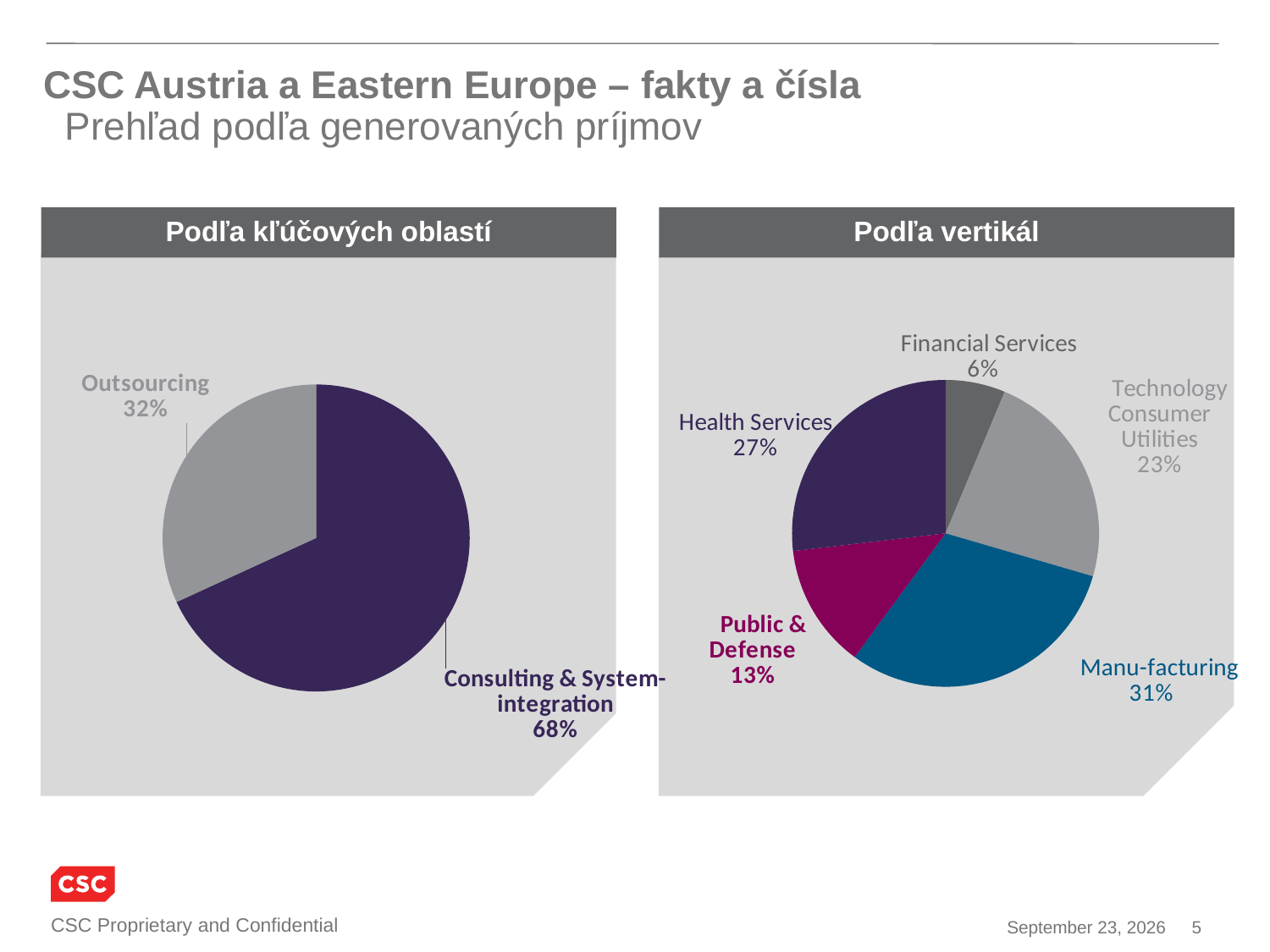
What kind of chart is shown in the 'Podľa kľúčových oblastí' panel? Pie chart In the 'Podľa kľúčových oblastí' chart, what is the difference between Consulting & System-integration and Outsourcing? 36% In the 'Podľa vertikál' chart, what share does Health Services have? 27% In the 'Podľa kľúčových oblastí' chart, what share does Outsourcing have? 32% In the 'Podľa vertikál' chart, which slice is the largest? Manu-facturing In the 'Podľa vertikál' chart, how many slices does the pie have? 5 In the 'Podľa vertikál' chart, which slice is the smallest? Financial Services In the 'Podľa kľúčových oblastí' chart, which slice is the largest? Consulting & System-integration In the 'Podľa vertikál' chart, what share does Manu-facturing have? 31% In the 'Podľa kľúčových oblastí' chart, what share does Consulting & System-integration have? 68% In the 'Podľa vertikál' chart, which is larger: Public & Defense or Technology Consumer Utilities? Technology Consumer Utilities In the 'Podľa vertikál' chart, what is the difference between Manu-facturing and Financial Services? 25%